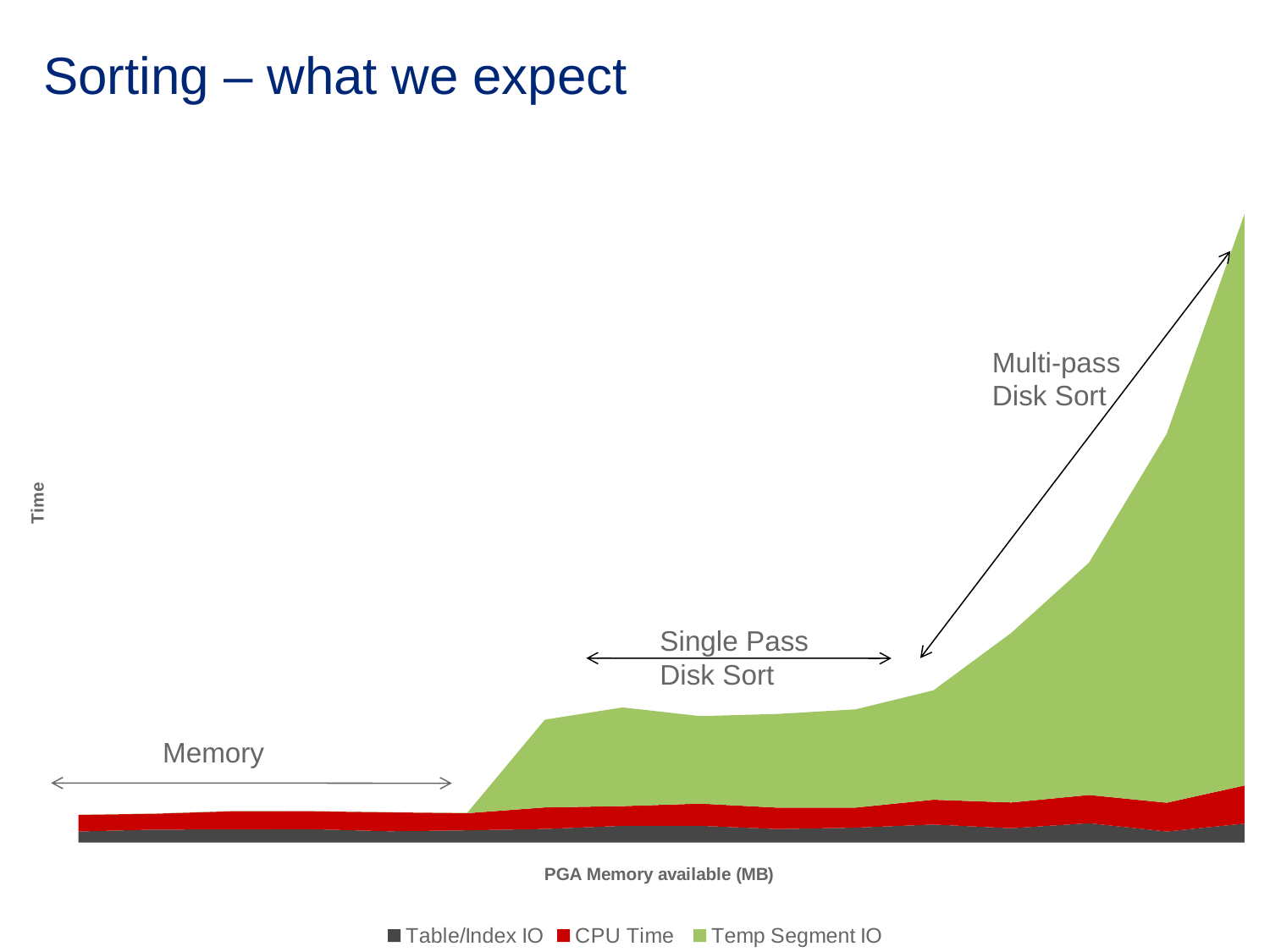
At the right-hand end of the chart, is the Temp Segment IO area larger or smaller than the CPU Time area? Larger Which series is shown in red? CPU Time Does the total time rise or fall as you move from left to right along the x axis? Rise Which series contributes the least to the total time across the chart? Table/Index IO How many series does the legend list? 3 Which series is shown in green? Temp Segment IO Which series contributes the most to the total time at the right-hand end of the chart? Temp Segment IO How many labelled regions (sort modes) are annotated along the x axis of the chart? 3 What kind of chart is shown on the slide? Stacked area chart What is the title of the chart on the slide? Sorting – what we expect